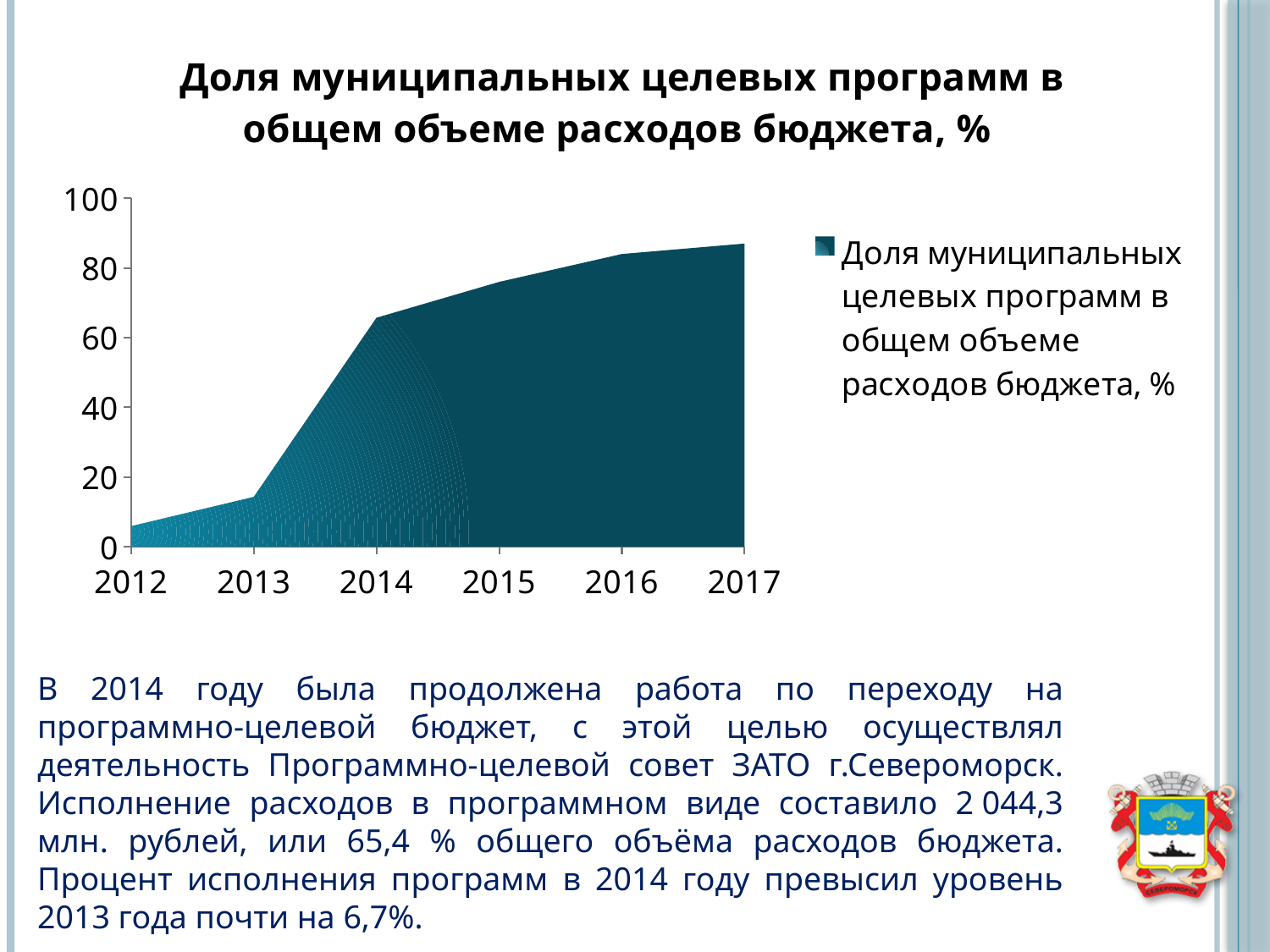
How many years are shown on the x axis of the chart? 6 Is the value for 2012 greater or less than 20? less What is the title of the chart? Доля муниципальных целевых программ в общем объеме расходов бюджета, % Do the values rise or fall from 2012 to 2017? rise Is the value for 2017 greater or less than 80? greater Which year has the larger value, 2013 or 2014? 2014 Which year has the lowest share of municipal target programmes in total budget expenditure? 2012 Is the value for 2013 greater or less than 20? less Which year has the highest share of municipal target programmes in total budget expenditure? 2017 What kind of chart is shown on the slide? area chart How many series does the legend list? 1